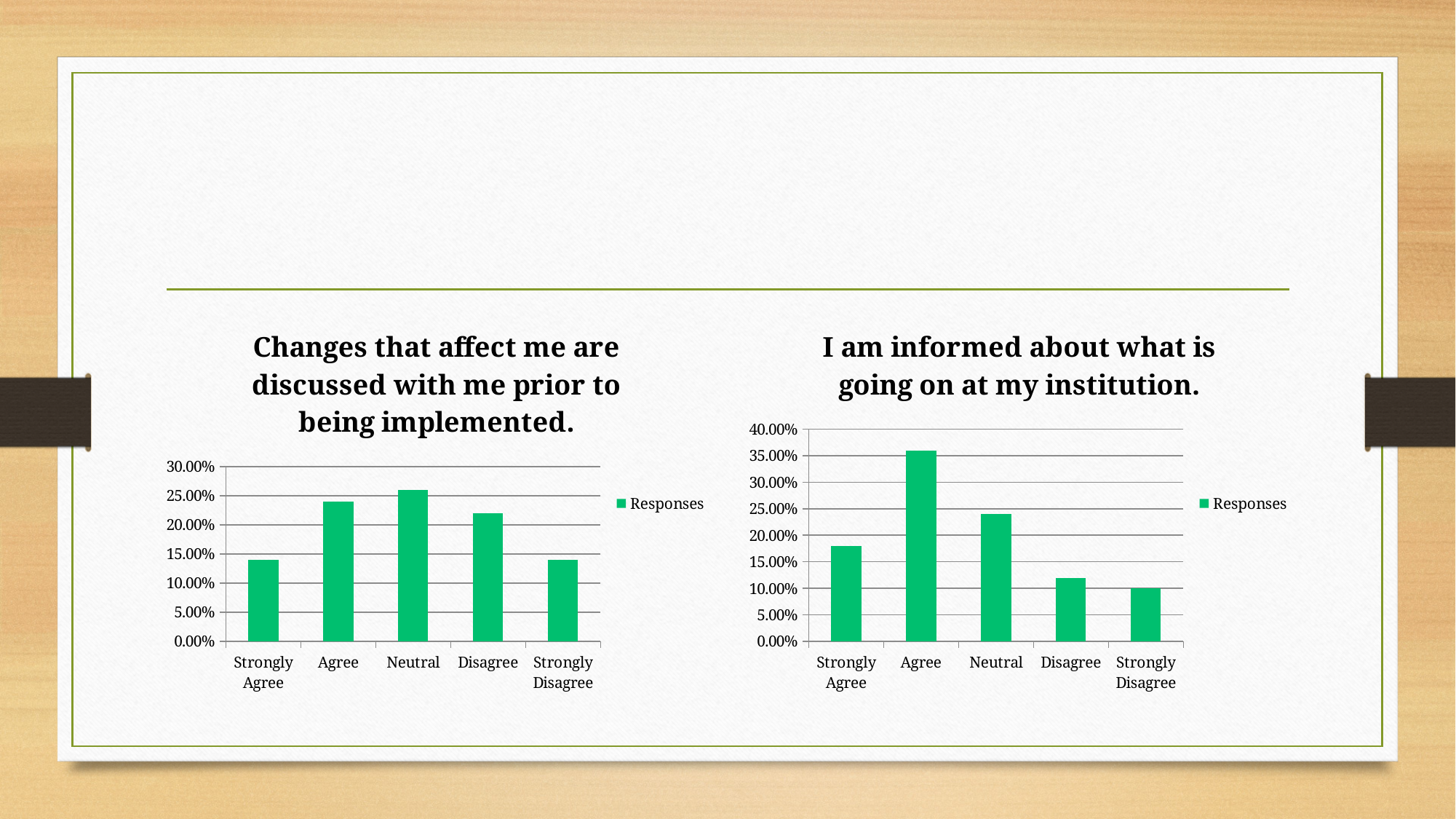
In the chart titled "Changes that affect me are discussed with me prior to being implemented.", is the value for Disagree greater or less than 20.00%? greater In the chart titled "I am informed about what is going on at my institution.", is the value for Strongly Agree greater or less than 20.00%? less In the chart titled "I am informed about what is going on at my institution.", which is larger, the value for Neutral or the value for Disagree? Neutral In the chart titled "I am informed about what is going on at my institution.", is the value for Agree greater or less than 30.00%? greater How many series does the legend list in the chart titled "Changes that affect me are discussed with me prior to being implemented."? 1 How many categories are shown on the x axis of the chart titled "I am informed about what is going on at my institution."? 5 In the chart titled "Changes that affect me are discussed with me prior to being implemented.", which is larger, the value for Agree or the value for Strongly Agree? Agree In the chart titled "Changes that affect me are discussed with me prior to being implemented.", which category has the highest value? Neutral In the chart titled "I am informed about what is going on at my institution.", which category has the highest value? Agree What kind of chart is the chart titled "Changes that affect me are discussed with me prior to being implemented."? bar chart In the chart titled "I am informed about what is going on at my institution.", which category has the lowest value? Strongly Disagree